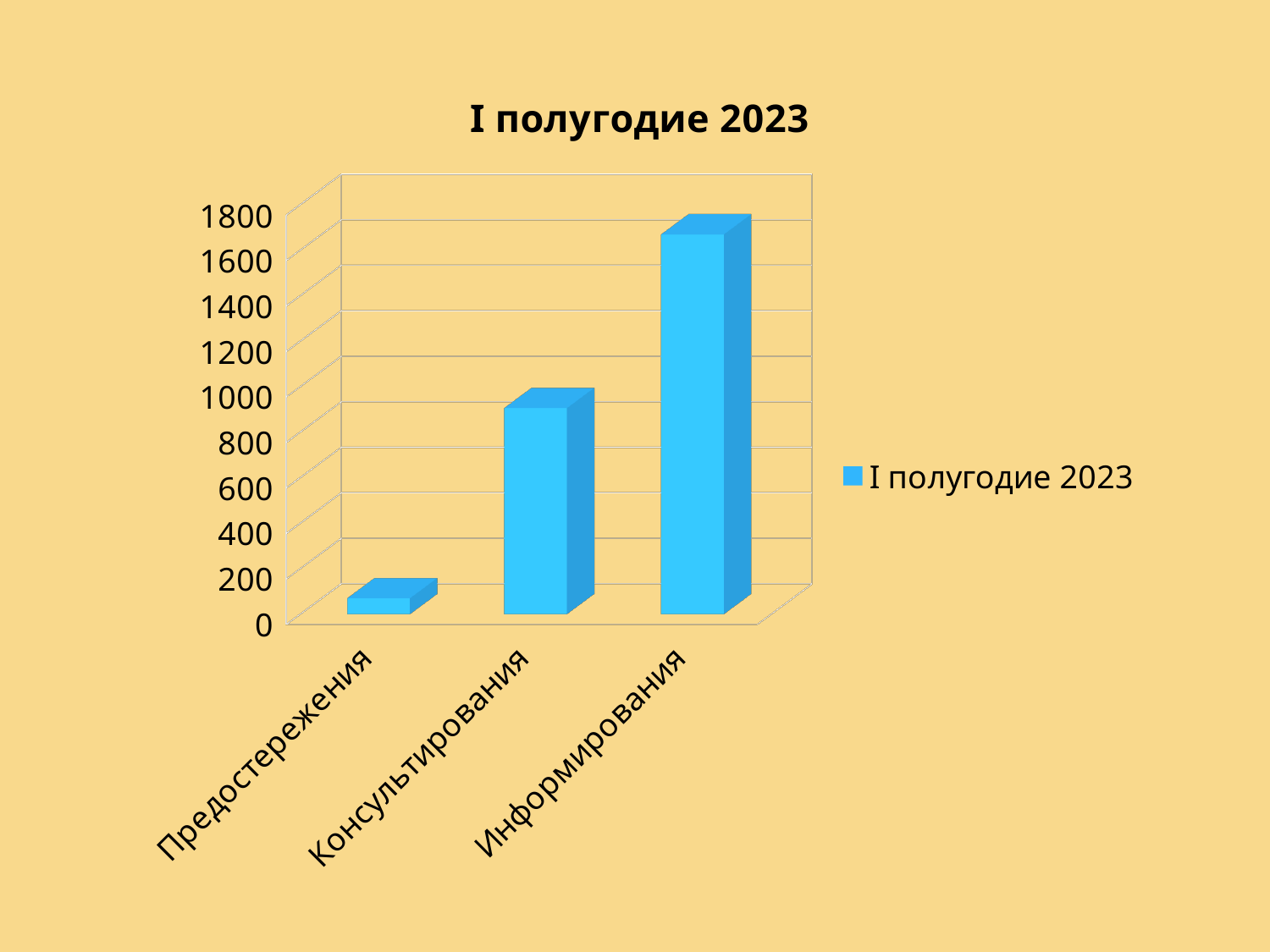
How many series does the legend list? 1 Which category has the lowest value? Предостережения Which category has the highest value? Информирования Do the values rise or fall from left to right along the x axis? rise What kind of chart is shown on the slide? bar chart Which is larger, the value for Консультирования or the value for Предостережения? Консультирования How many categories are shown on the x axis of the chart? 3 Is the value for Консультирования greater or less than 600? greater What is the title of the chart? I полугодие 2023 Is the value for Информирования greater or less than 1400? greater Is the value for Консультирования greater or less than 1000? less